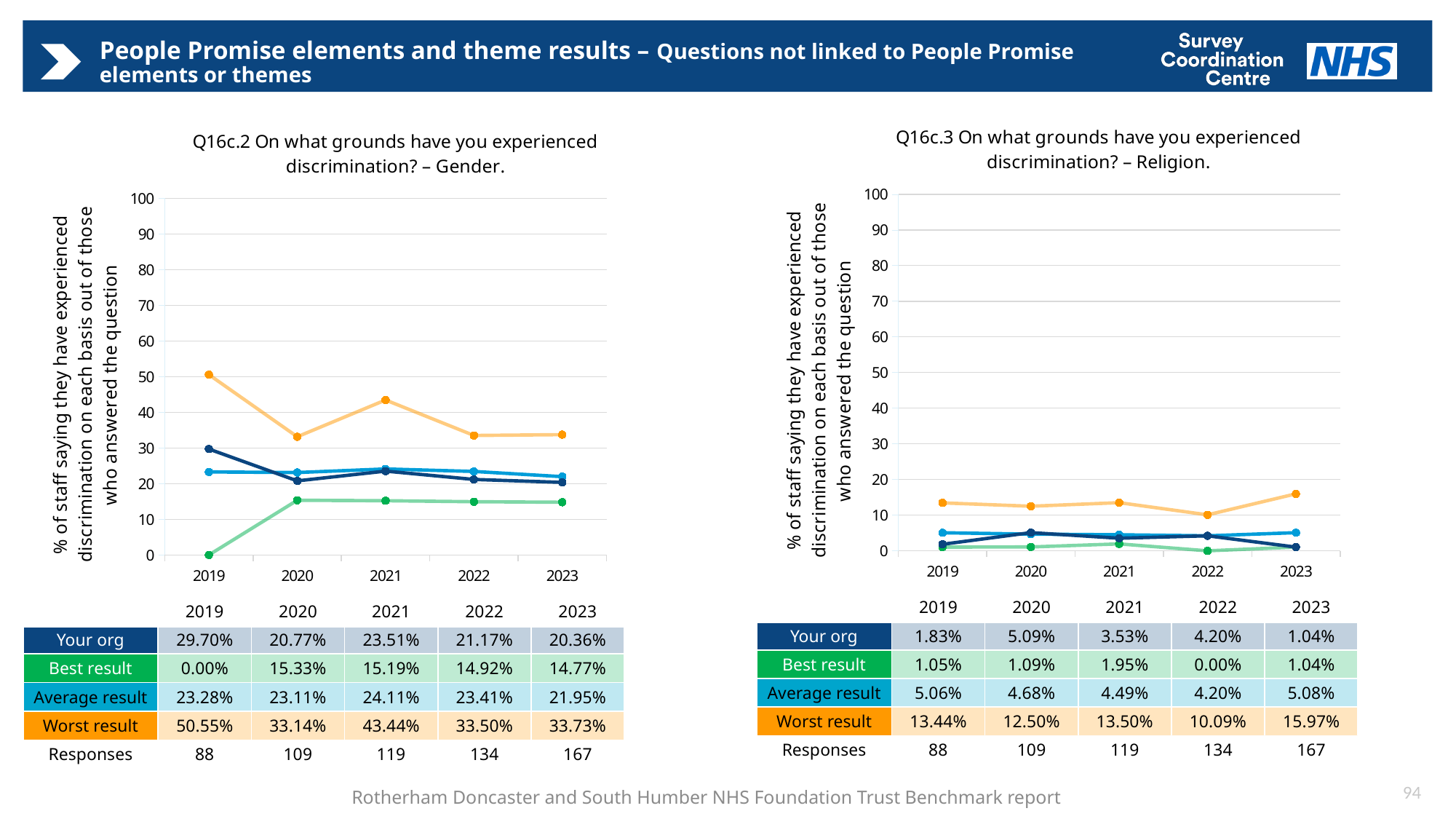
In the Q16c.2 Gender chart, which year has the lowest Best result value? 2019 In the Q16c.3 Religion chart, how many responses were recorded for 2023? 167 In the Q16c.2 Gender chart, which year has the highest Worst result value? 2019 In the Q16c.2 Gender chart, what is the Worst result value for 2021? 43.44% In the Q16c.2 Gender chart, is the Your org value for 2019 greater or less than 20? greater In the Q16c.3 Religion chart, is the Your org value larger in 2020 or in 2023? 2020 In the Q16c.3 Religion chart, which year has the highest Worst result value? 2023 In the Q16c.2 Gender chart, what is the difference between the Worst result and Your org values in 2023? 13.37% In the Q16c.3 Religion chart, what is the Average result value for 2022? 4.20% In the Q16c.2 Gender chart, what is the Your org value for 2019? 29.70% What kind of chart is the Q16c.3 Religion chart? Line chart In the Q16c.3 Religion chart, how many years are plotted on the x axis? 5